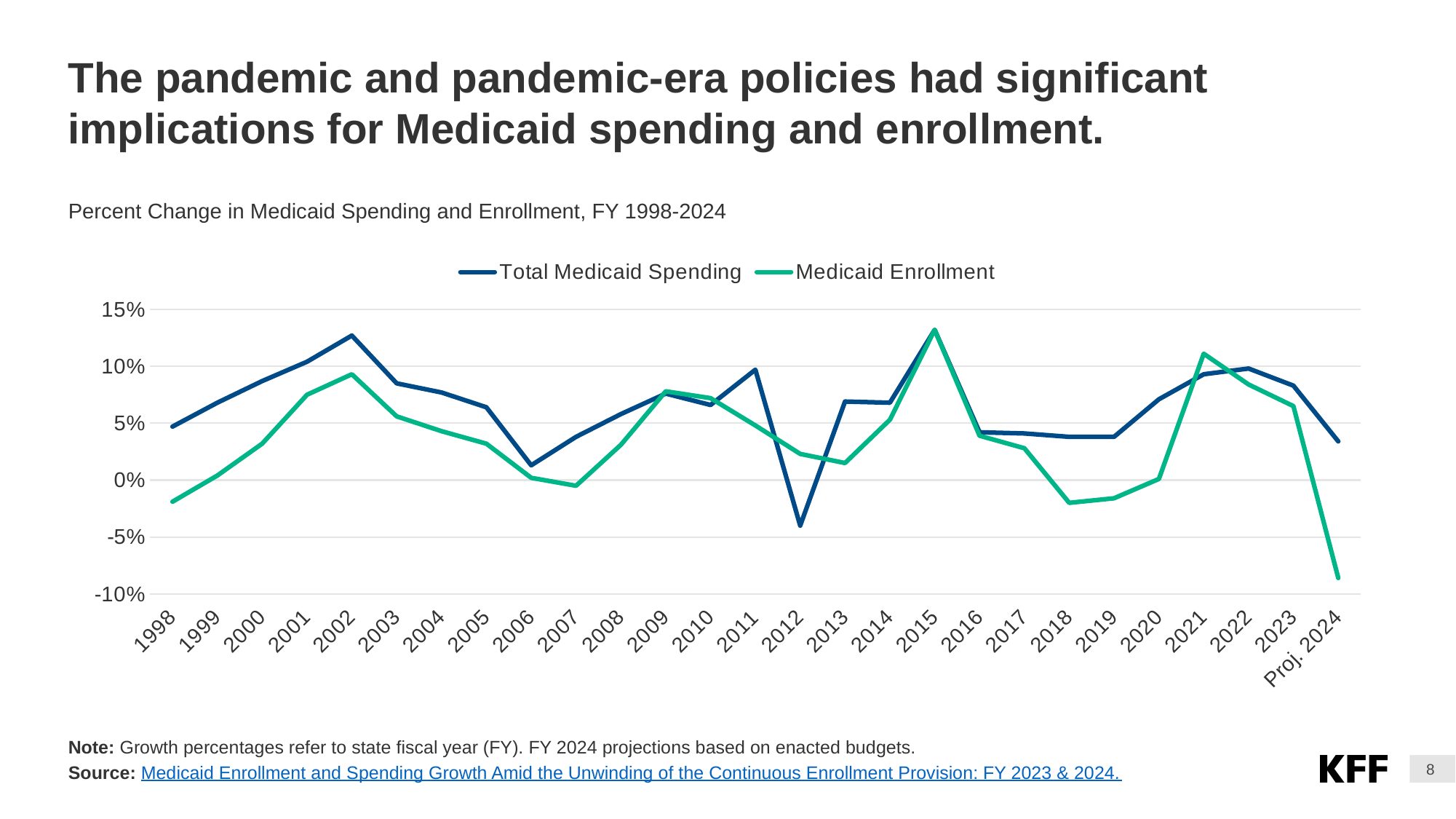
How many series does the legend list? 2 In which year is Total Medicaid Spending growth lowest? 2012 Is the Medicaid Enrollment value for 2021 greater or less than 10%? greater In which year is Medicaid Enrollment growth lowest? Proj. 2024 Is the Total Medicaid Spending value for 2012 greater or less than 0%? less Is the Medicaid Enrollment value for Proj. 2024 greater or less than -5%? less How many years (points) are plotted along the x axis? 27 Does Medicaid Enrollment growth rise or fall from 2021 to Proj. 2024? fall In 2021, which series has the larger value, Total Medicaid Spending or Medicaid Enrollment? Medicaid Enrollment In which year is Medicaid Enrollment growth highest? 2015 What kind of chart is shown on the slide? line chart In 1998, which series has the larger value, Total Medicaid Spending or Medicaid Enrollment? Total Medicaid Spending